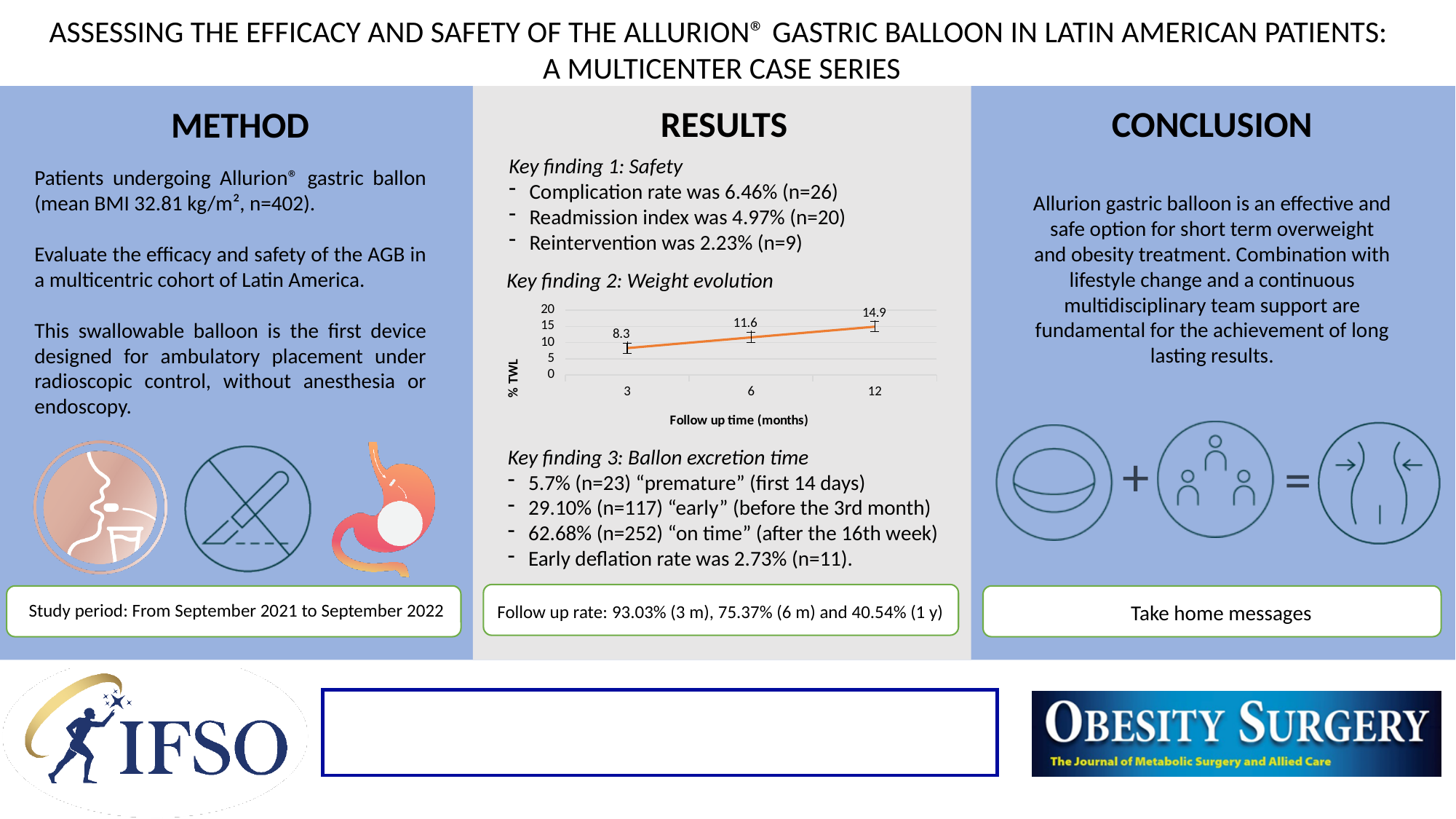
What is the % TWL at 12 months of follow up? 14.9 What is the % TWL at 3 months of follow up? 8.3 How many follow up time points are plotted on the chart? 3 What is the difference in % TWL between 12 months and 3 months? 6.6 Does the % TWL rise or fall as follow up time increases? rise What is the difference in % TWL between 6 months and 3 months? 3.3 What kind of chart is used to show the weight evolution? line chart Is the % TWL at 3 months greater or less than 10? less At which follow up time is the % TWL highest? 12 Which has a higher % TWL, 6 months or 12 months? 12 months At which follow up time is the % TWL lowest? 3 What is the % TWL at 6 months of follow up? 11.6